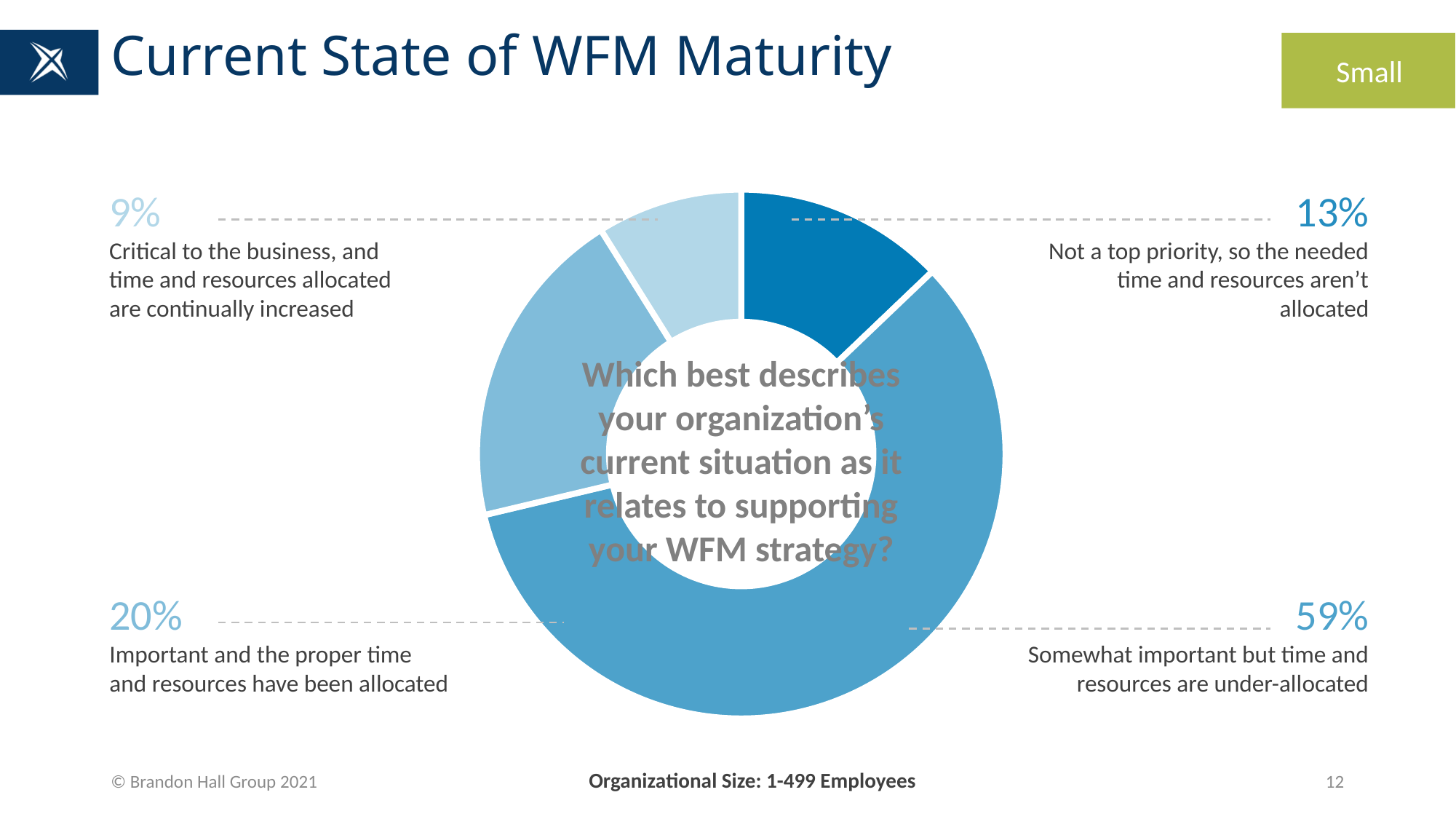
How many response categories are shown in the chart? 4 Which response category has the smallest share of the chart? Critical to the business, and time and resources allocated are continually increased What percentage of respondents said WFM is 'Important and the proper time and resources have been allocated'? 20% What kind of chart is shown on the slide? Donut (pie) chart Which is larger: the share for 'Not a top priority' or the share for 'Critical to the business'? Not a top priority What question is written in the center of the chart? Which best describes your organization's current situation as it relates to supporting your WFM strategy? What percentage of respondents said WFM is 'Not a top priority, so the needed time and resources aren't allocated'? 13% What percentage of respondents said WFM is 'Somewhat important but time and resources are under-allocated'? 59% Which response category has the largest share of the chart? Somewhat important but time and resources are under-allocated What organizational size does the chart on this slide cover? 1-499 Employees What percentage of respondents said WFM is 'Critical to the business, and time and resources allocated are continually increased'? 9% What is the difference in percentage points between the 'Somewhat important' response and the 'Important and the proper time and resources have been allocated' response? 39